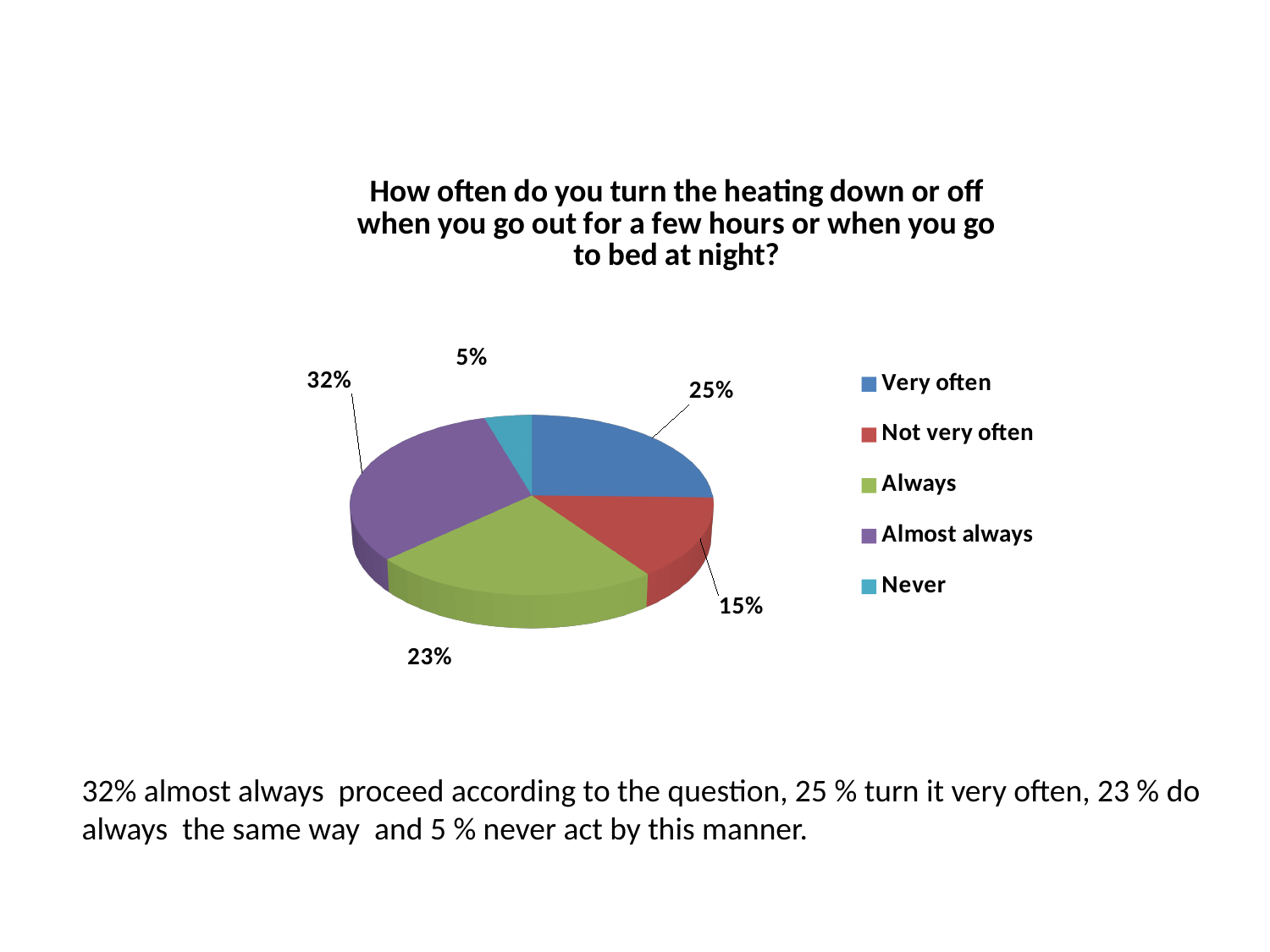
What percentage of respondents answered "Always"? 23% Which response has the largest share of the pie? Almost always Which response has the smallest share of the pie? Never How many response categories does the legend list? 5 What percentage of respondents answered "Not very often"? 15% What colour is the "Always" slice? Green What percentage of respondents answered "Very often"? 25% Which is larger, the share for "Always" or the share for "Not very often"? Always What percentage of respondents answered "Never"? 5% What kind of chart is shown on the slide? Pie chart What is the difference in percentage points between "Almost always" and "Very often"? 7 What percentage of respondents answered "Almost always"? 32%